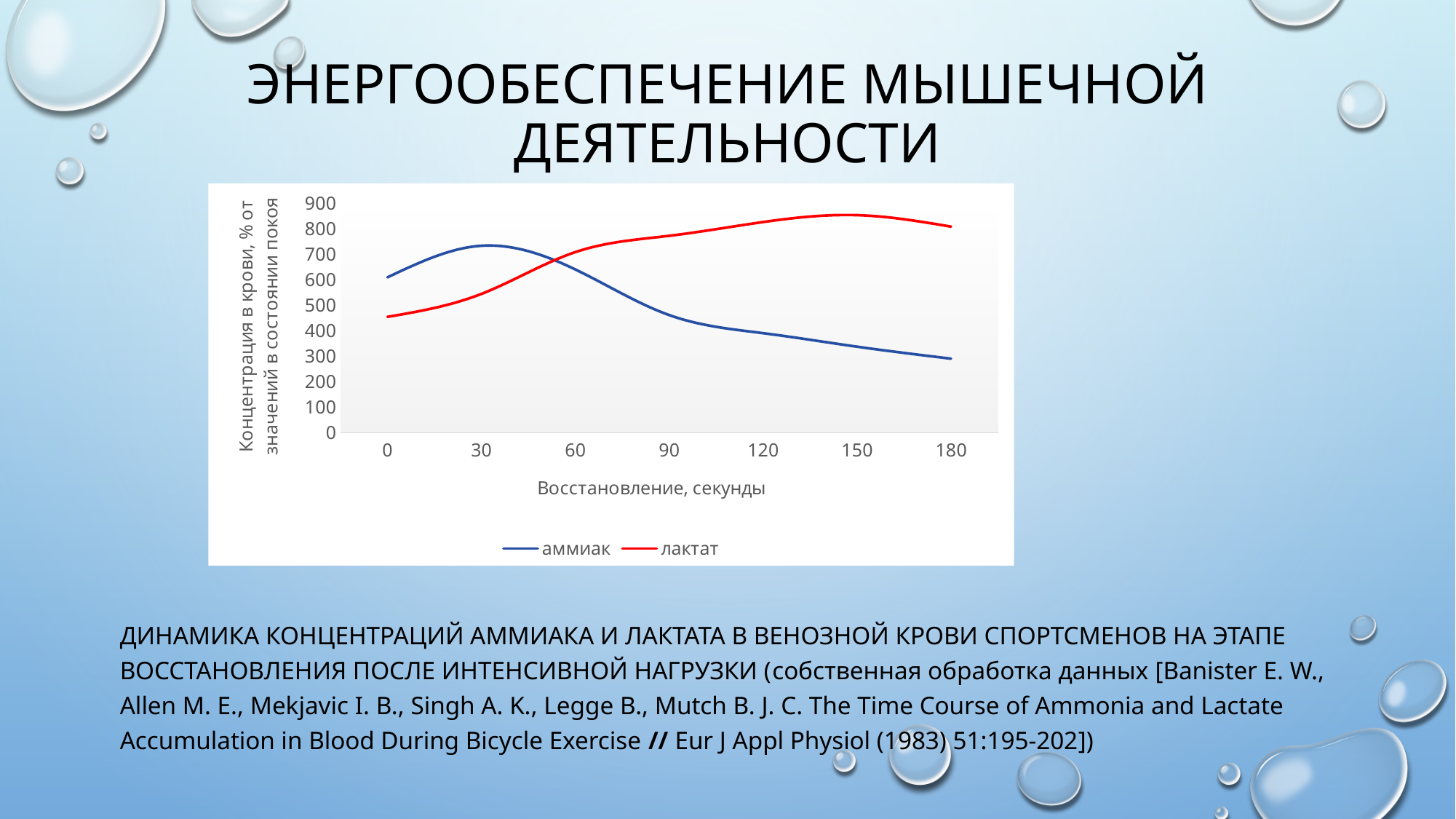
What is the title of the x axis of the chart? Восстановление, секунды What are the two series named in the chart legend? аммиак and лактат Is the value for аммиак at 90 seconds greater or less than 500? less How many tick labels are shown on the x axis of the chart? 7 Is the value for лактат at 150 seconds greater or less than 800? greater How many series does the chart legend list? 2 At 0 seconds, which series has the higher value, аммиак or лактат? аммиак Is the value for лактат at 0 seconds greater or less than 500? less Does the аммиак line rise or fall between 30 and 180 seconds? fall What kind of chart is shown on the slide? line chart At 180 seconds, which series has the higher value, аммиак or лактат? лактат